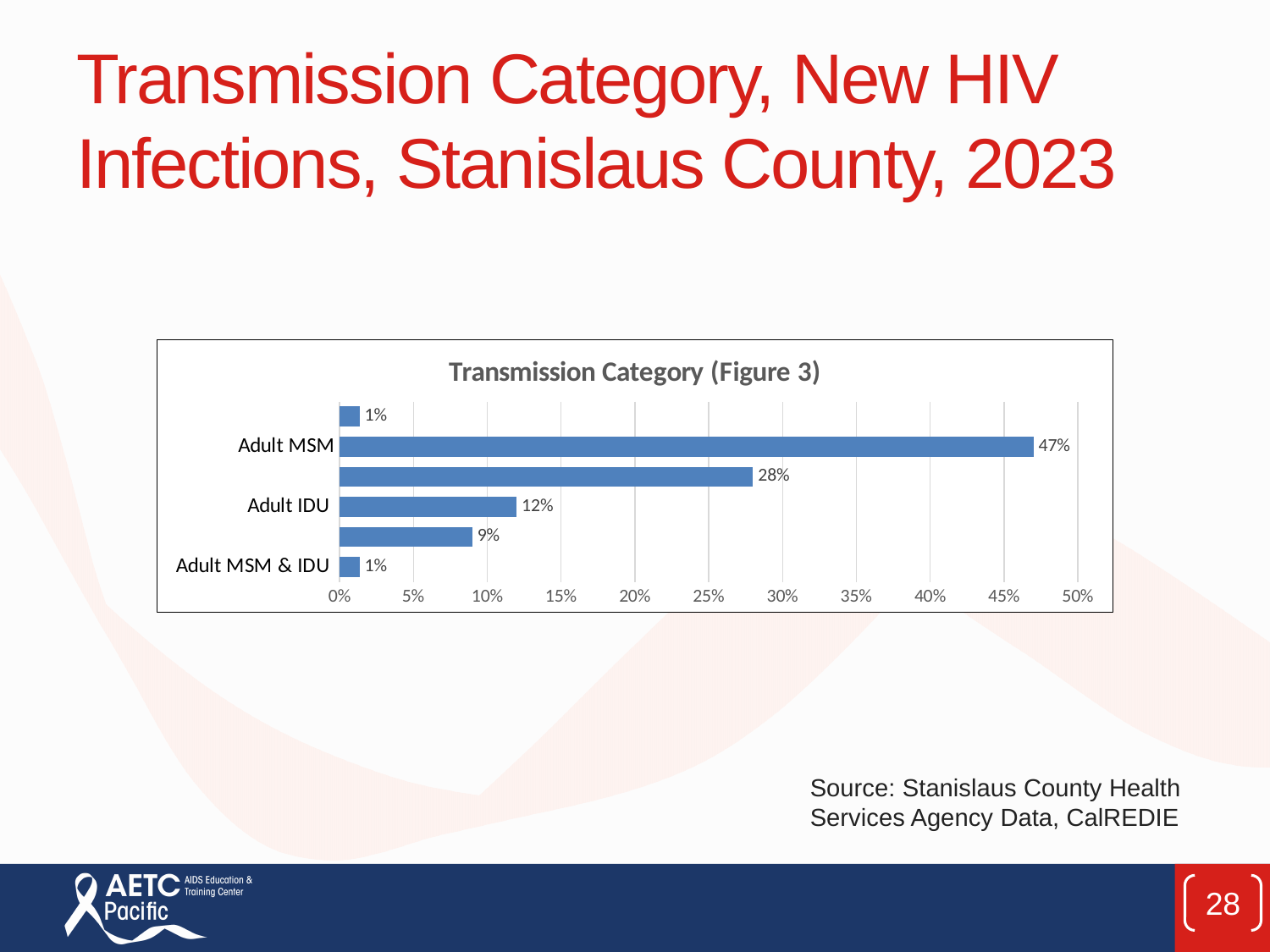
Which labelled category has the highest value? Adult MSM What kind of chart is shown on the slide? bar chart What is the value for Adult IDU? 12% What is the title of the chart? Transmission Category (Figure 3) How many bars are plotted on the chart? 6 What is the difference between the values for Adult IDU and Adult MSM & IDU? 11% Which is larger, the value for Adult MSM or the value for Adult IDU? Adult MSM What is the value for Adult MSM & IDU? 1% Is the value for Adult MSM greater or less than 45%? greater What is the value for Adult MSM? 47% What is the difference between the values for Adult MSM and Adult IDU? 35% What is the highest value shown on the chart? 47%